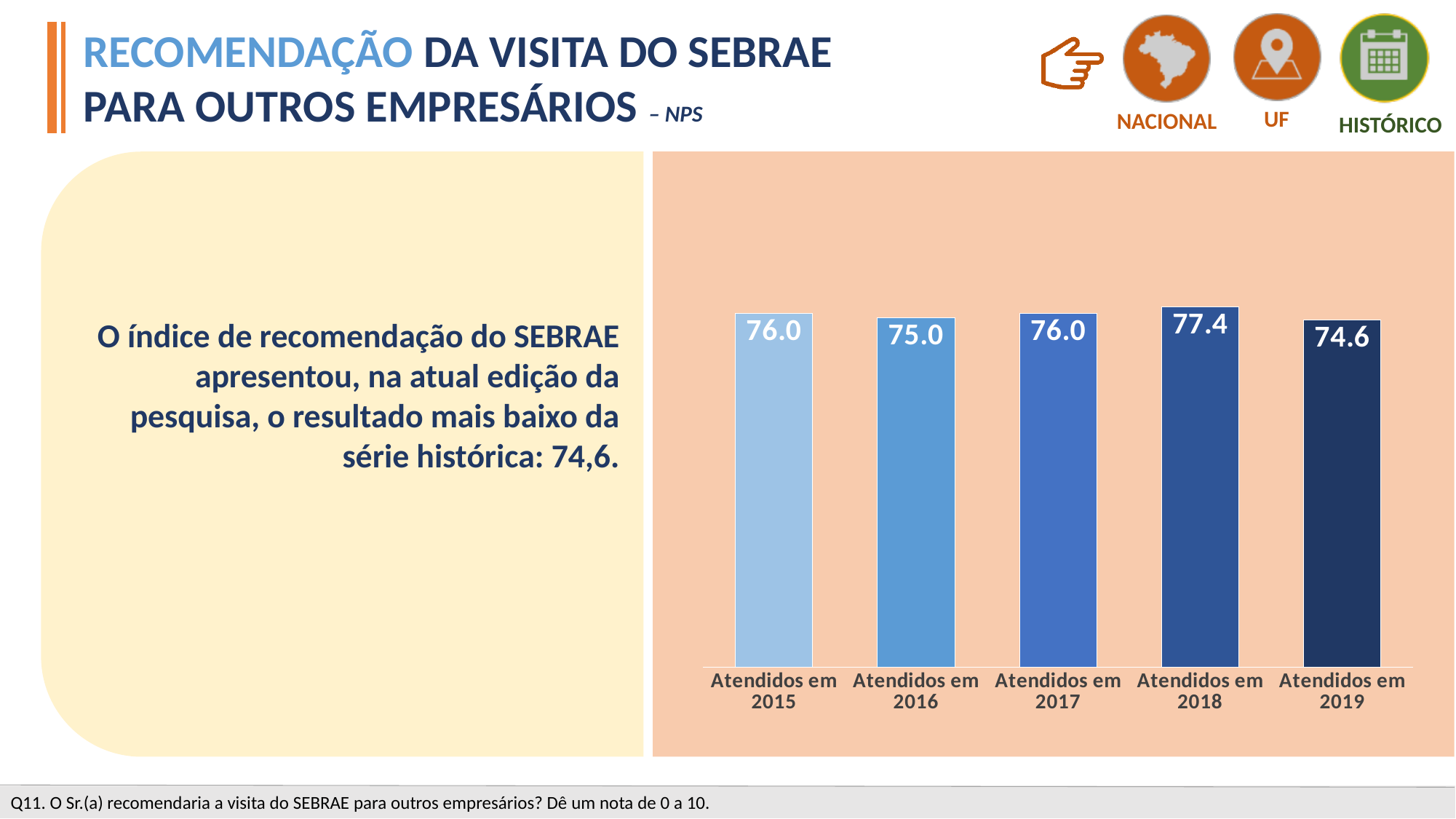
Does the value rise or fall from Atendidos em 2018 to Atendidos em 2019? fall What is the value for Atendidos em 2018? 77.4 What is the difference between the values for Atendidos em 2018 and Atendidos em 2019? 2.8 What is the difference between the values for Atendidos em 2017 and Atendidos em 2016? 1.0 Which category has the lowest value? Atendidos em 2019 What is the value for Atendidos em 2015? 76.0 What kind of chart is shown on the slide? bar chart How many categories are shown on the chart? 5 What is the value for Atendidos em 2016? 75.0 Which category has the highest value? Atendidos em 2018 What is the value for Atendidos em 2019? 74.6 Which is larger, the value for Atendidos em 2016 or the value for Atendidos em 2019? Atendidos em 2016